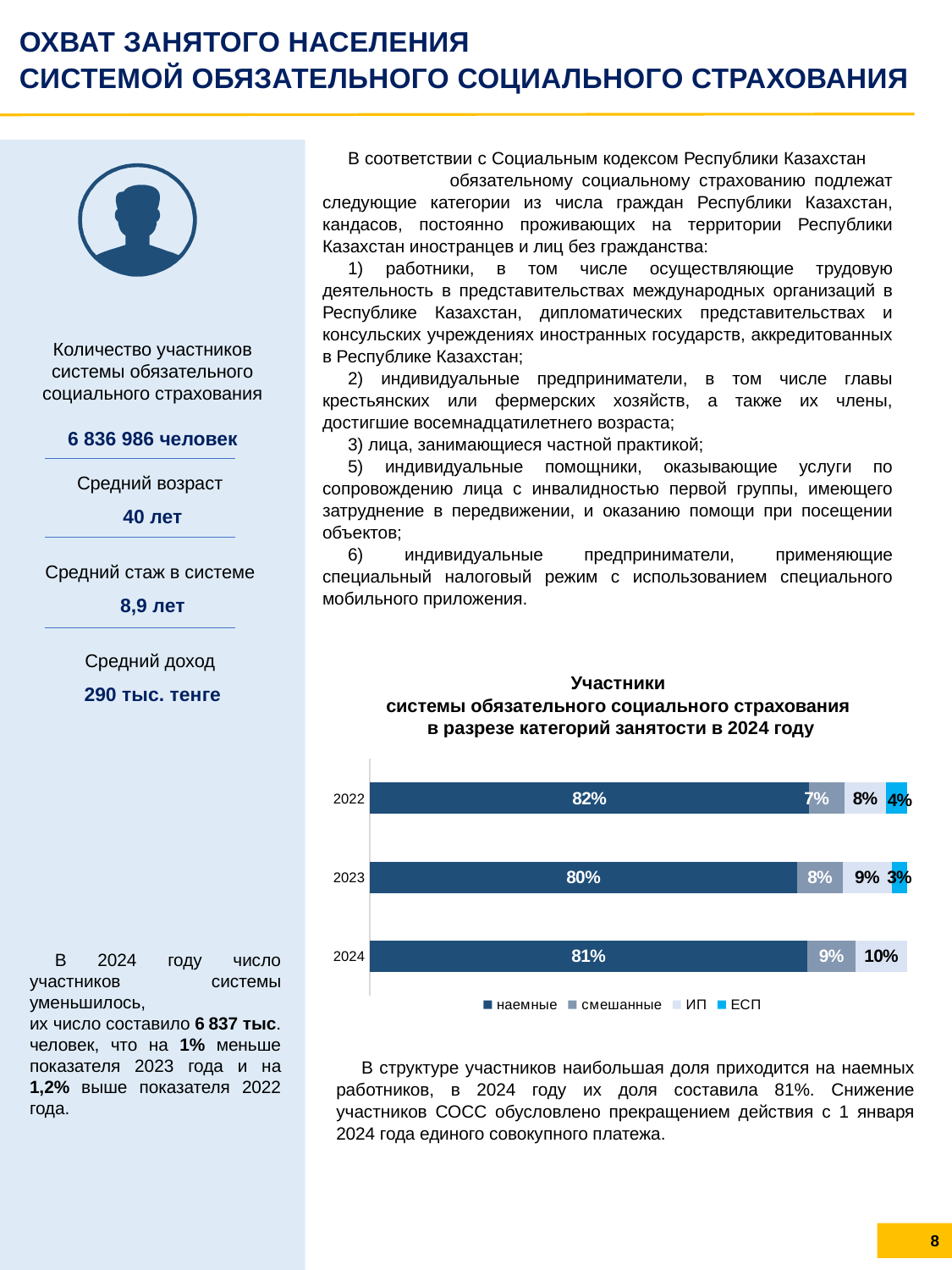
Which is larger: the share of смешанные in 2023 or in 2024? 2024 How many years are shown on the chart? 3 How many series does the legend list? 4 What is the share of наемные in 2024? 81% What type of chart is shown on the slide? Stacked bar chart What is the difference between the share of наемные in 2022 and in 2023? 2% In which year is the share of наемные the highest? 2022 What is the share of ИП in 2023? 9% In which year is the share of ИП the lowest? 2022 Does the share of ИП rise or fall from 2022 to 2024? Rise What is the share of ЕСП in 2022? 4% What is the share of смешанные in 2024? 9%